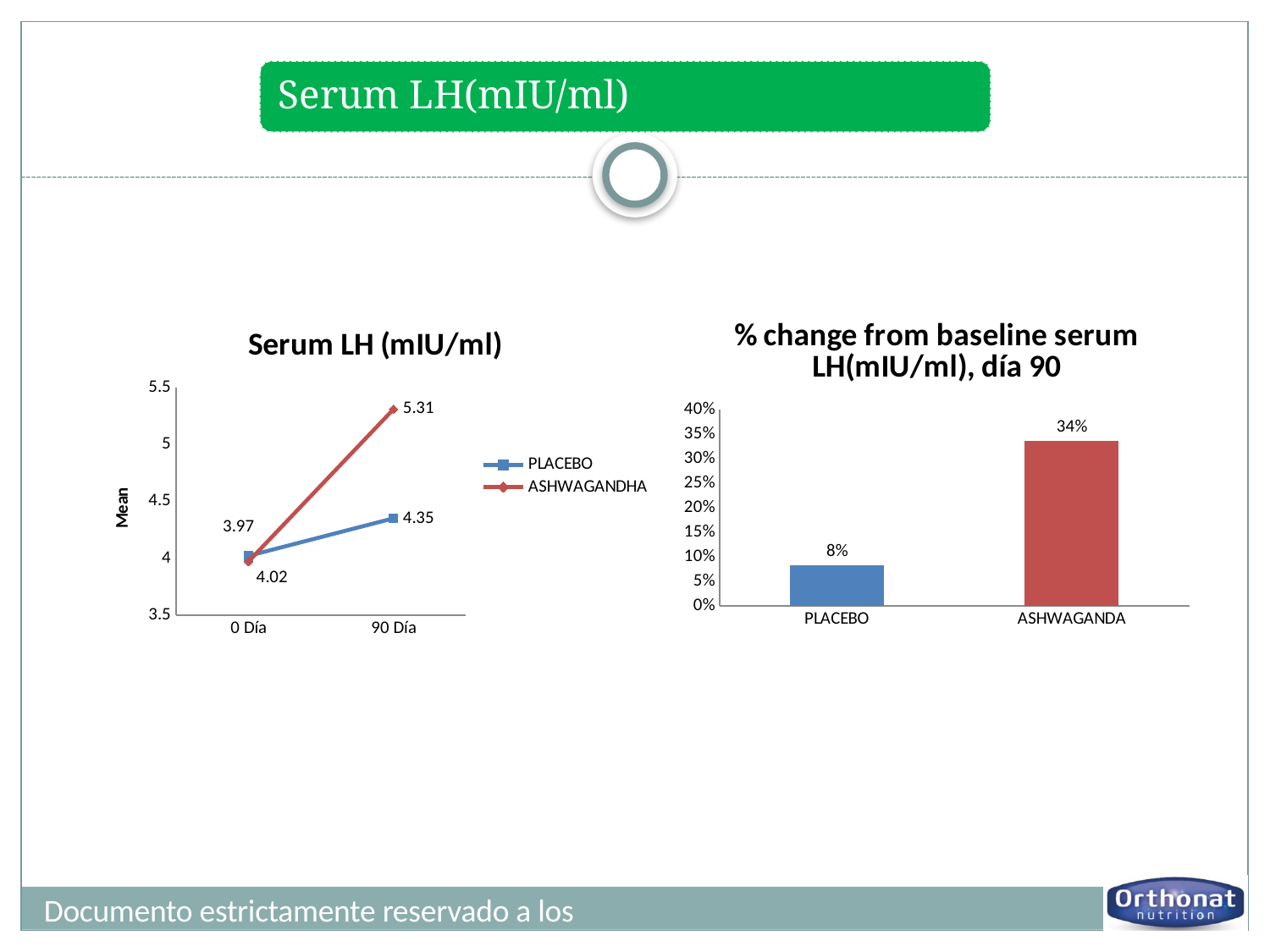
In the 'Serum LH (mIU/ml)' line chart, does the ASHWAGANDHA series rise or fall from 0 Día to 90 Día? rise In the 'Serum LH (mIU/ml)' line chart, how many series does the legend list? 2 What kind of chart is the '% change from baseline serum LH(mIU/ml), día 90' chart? bar chart In the 'Serum LH (mIU/ml)' line chart, what is the value for PLACEBO at 90 Día? 4.35 In the '% change from baseline serum LH(mIU/ml), día 90' chart, what is the difference between the ASHWAGANDA and PLACEBO values? 26% In the '% change from baseline serum LH(mIU/ml), día 90' chart, which category has the highest value? ASHWAGANDA In the '% change from baseline serum LH(mIU/ml), día 90' chart, what is the value for PLACEBO? 8% In the '% change from baseline serum LH(mIU/ml), día 90' chart, what is the value for ASHWAGANDA? 34% In the 'Serum LH (mIU/ml)' line chart, what is the difference between the ASHWAGANDHA and PLACEBO values at 90 Día? 0.96 In the 'Serum LH (mIU/ml)' line chart, which series has the higher value at 90 Día? ASHWAGANDHA In the 'Serum LH (mIU/ml)' line chart, what is the label of the y axis? Mean In the 'Serum LH (mIU/ml)' line chart, what is the value for ASHWAGANDHA at 90 Día? 5.31